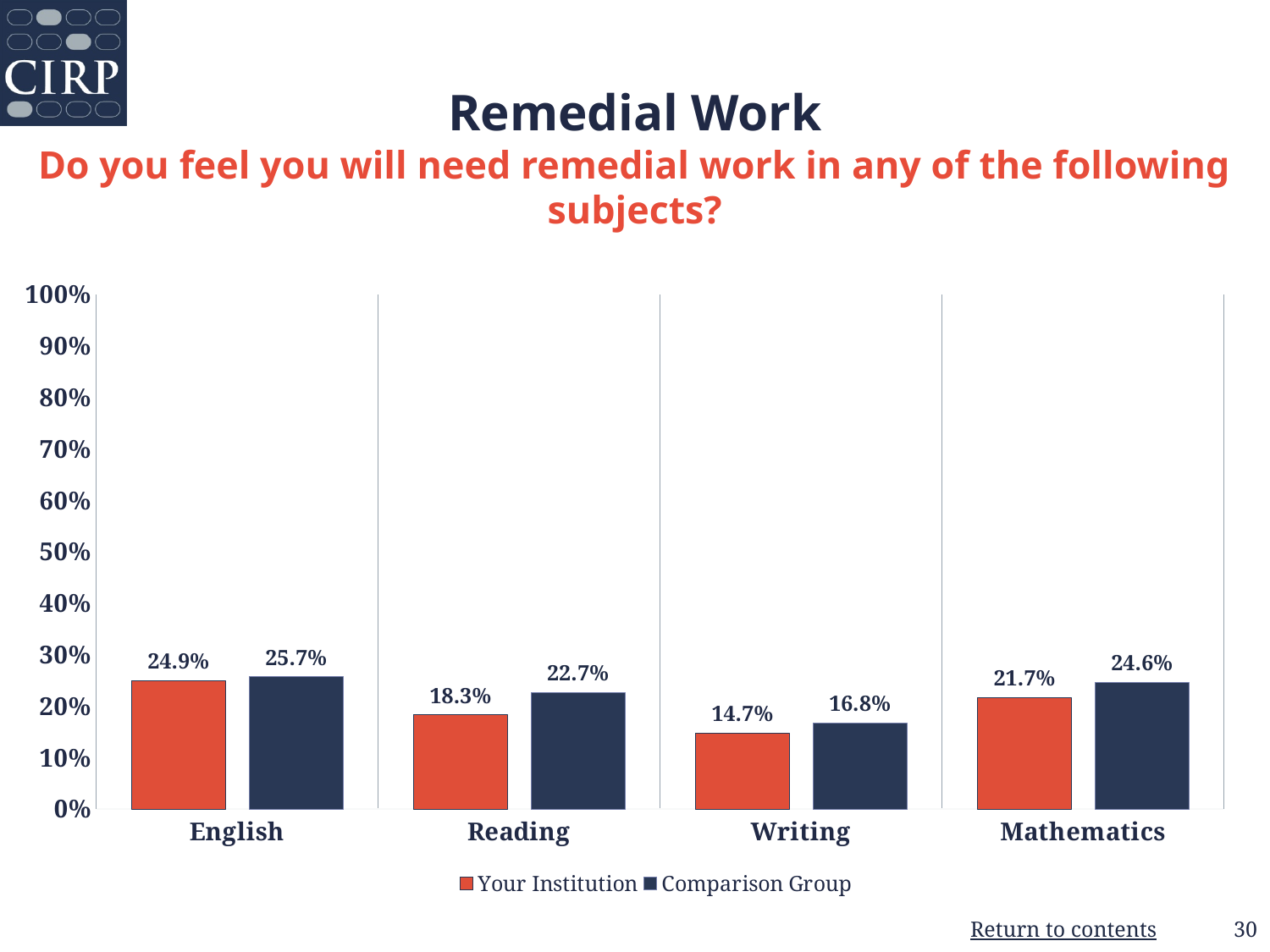
Which is larger in Mathematics: Your Institution or Comparison Group? Comparison Group What kind of chart is shown on the slide? Bar chart What is the value for Your Institution in English? 24.9% How many series does the legend list? 2 What is the value for Comparison Group in Mathematics? 24.6% Which subject has the highest value for Your Institution? English Which subject has the lowest value for Comparison Group? Writing What colour are the Your Institution bars? Orange-red What is the value for Your Institution in Writing? 14.7% What is the difference between Comparison Group and Your Institution in Reading? 4.4% What is the value for Comparison Group in Reading? 22.7% How many subjects are shown on the x axis? 4